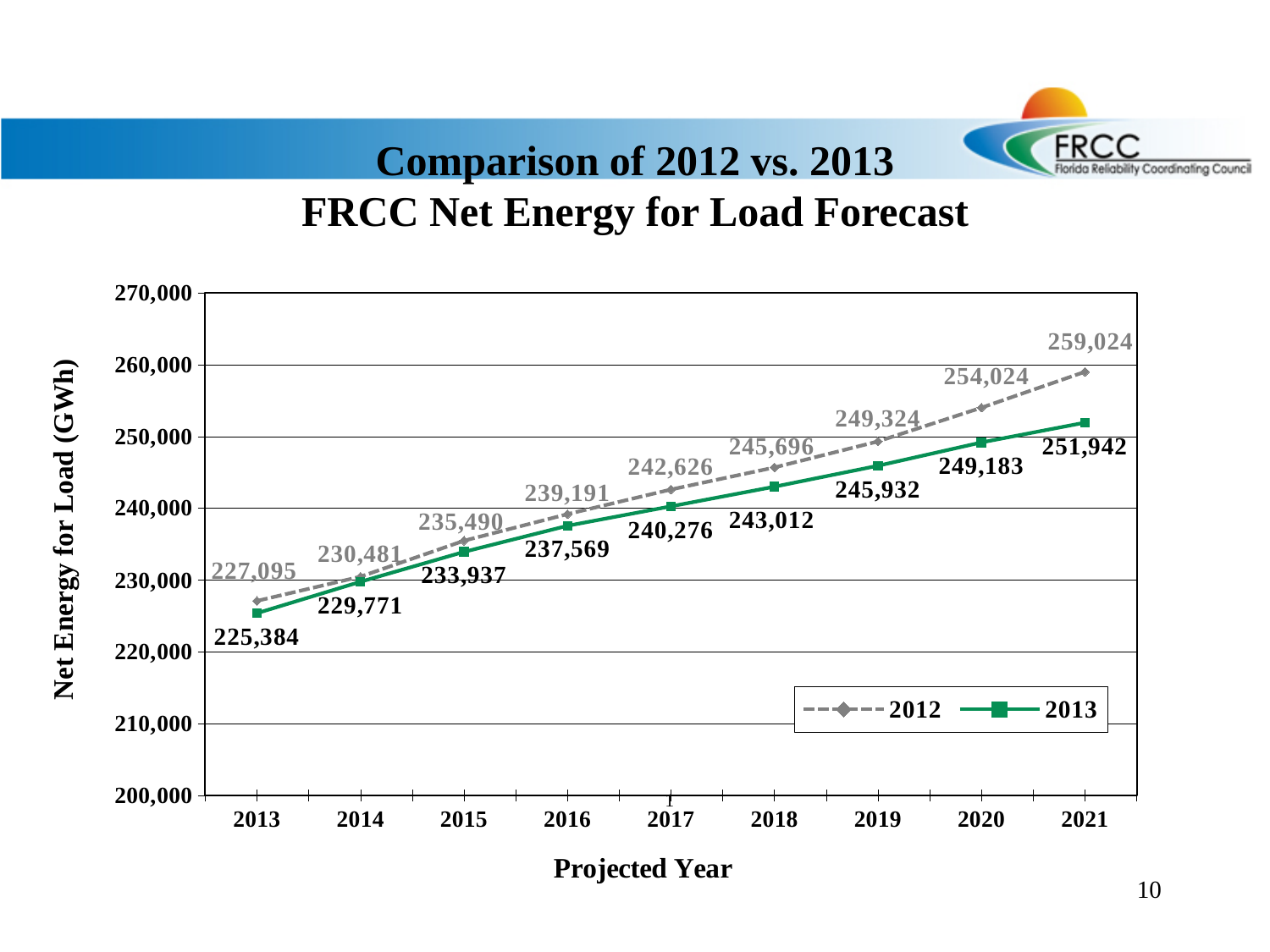
In which projected year is the 2013 forecast lowest? 2013 What is the difference between the 2012 and 2013 forecasts for the projected year 2013? 1,711 What is the 2012 forecast value for the projected year 2019? 249,324 In which projected year is the 2012 forecast highest? 2021 How many series does the legend list? 2 How many projected years are shown on the x axis? 9 For the projected year 2020, which forecast is larger, 2012 or 2013? 2012 What type of chart is shown on the slide? line chart What is the 2013 forecast value for the projected year 2021? 251,942 What is the 2013 forecast value for the projected year 2017? 240,276 What is the difference between the 2012 and 2013 forecasts for the projected year 2021? 7,082 Do the 2013 forecast values rise or fall from 2013 to 2021? rise